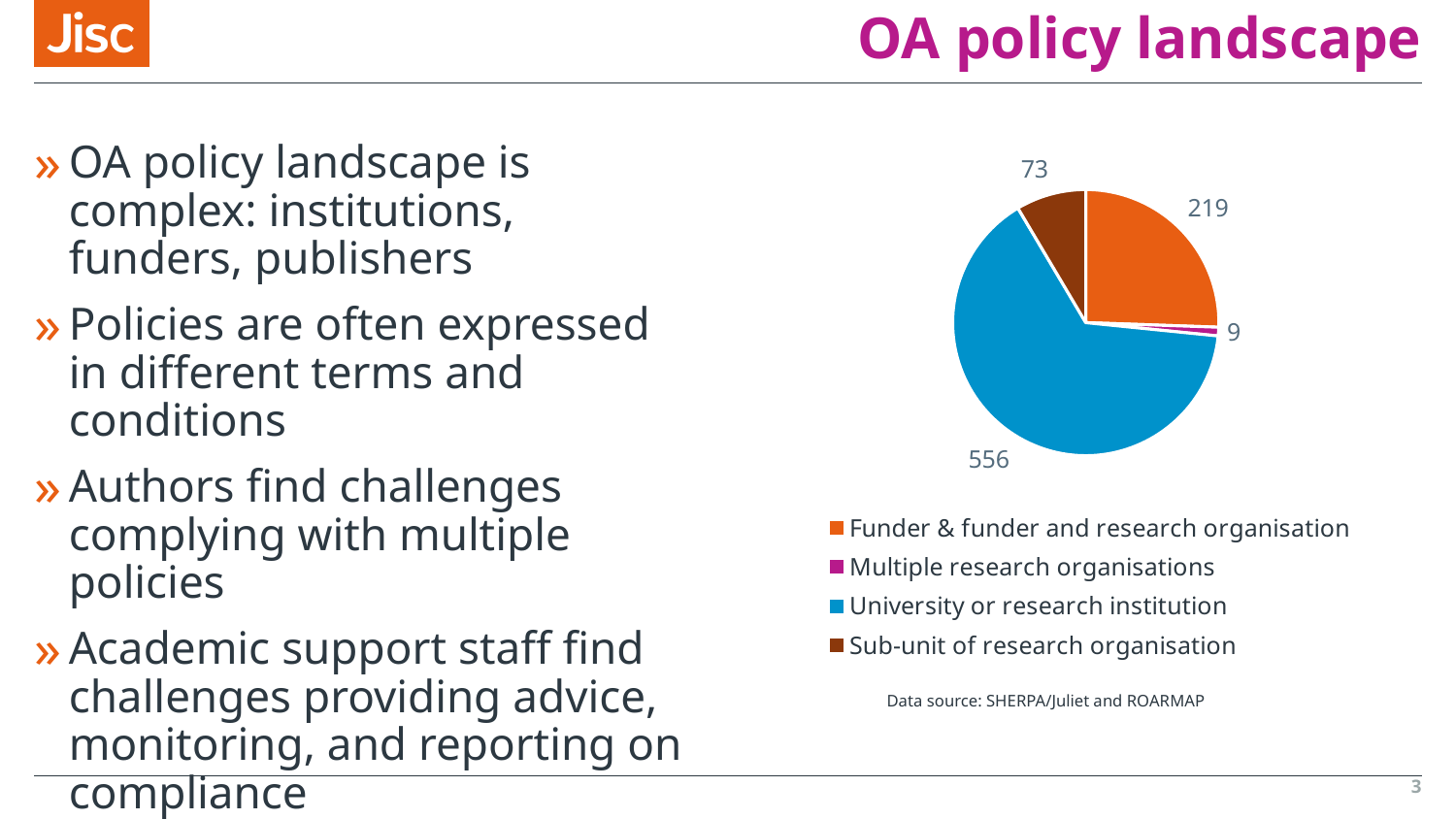
What is the difference between the values for University or research institution and Funder & funder and research organisation? 337 What kind of chart is shown on the slide? Pie chart What is the value for Multiple research organisations in the pie chart? 9 What is the value for University or research institution in the pie chart? 556 Which category has the largest slice in the pie chart? University or research institution What is the value for Funder & funder and research organisation in the pie chart? 219 Which category has the smallest slice in the pie chart? Multiple research organisations Which is larger: the value for Sub-unit of research organisation or the value for Multiple research organisations? Sub-unit of research organisation What is the value for Sub-unit of research organisation in the pie chart? 73 How many categories does the pie chart show? 4 What data source is cited below the pie chart? SHERPA/Juliet and ROARMAP What is the total of all the values shown in the pie chart? 857